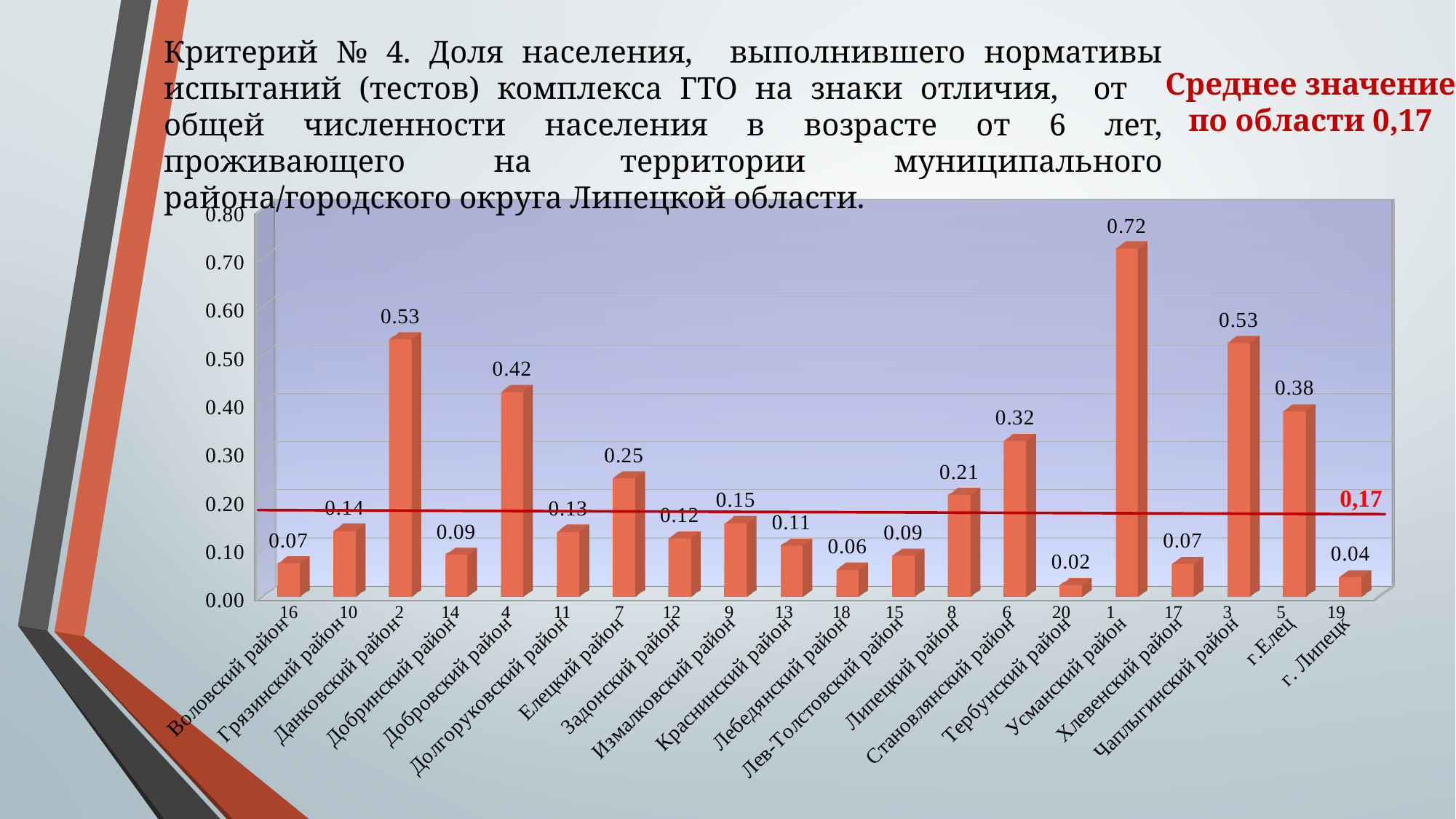
Which district has the lowest value? Тербунский район How many districts are shown on the chart? 20 Which district has the highest value? Усманский район Is the value for Елецкий район greater or less than 0.20? greater What is the difference between the values for Усманский район and Чаплыгинский район? 0.19 What is the value for Усманский район? 0.72 What is the difference between the values for Липецкий район and Задонский район? 0.09 Which is larger, the value for Становлянский район or the value for г.Елец? г.Елец What is the value for Добровский район? 0.42 What kind of chart is shown on the slide? bar chart What is the value of the horizontal red line on the chart? 0,17 What is the value for г. Липецк? 0.04